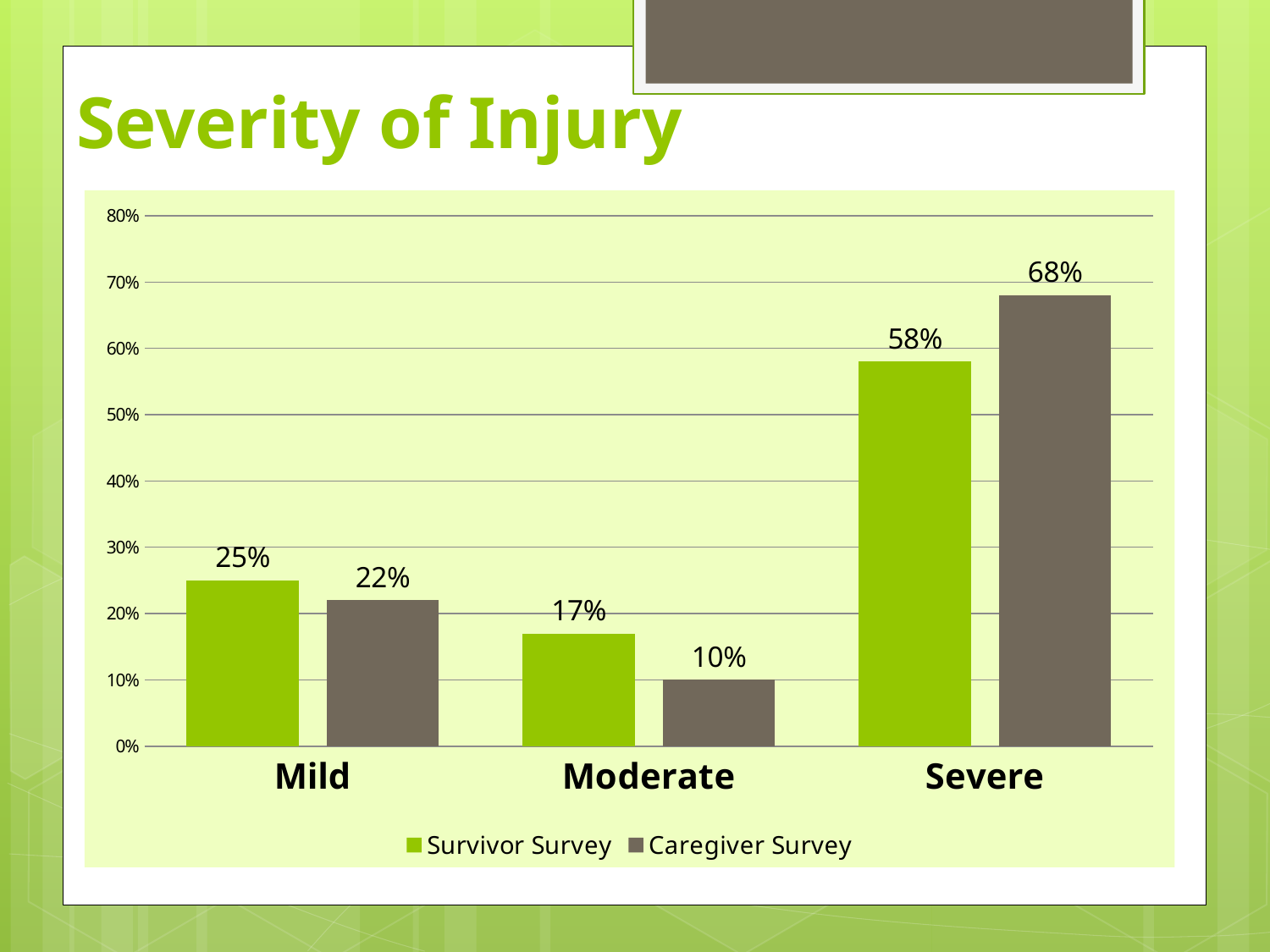
How many series does the legend list? 2 Which category has the highest Survivor Survey value? Severe What kind of chart is shown on the slide? bar chart How many categories are shown on the x axis? 3 What is the Caregiver Survey value for Moderate? 10% What is the difference between the Survivor Survey and Caregiver Survey values for Moderate? 7% Which category has the lowest Caregiver Survey value? Moderate Is the Survivor Survey value for Severe greater or less than 50%? greater What is the Caregiver Survey value for Severe? 68% Which is larger for Mild, the Survivor Survey value or the Caregiver Survey value? Survivor Survey What is the Survivor Survey value for Mild? 25% What is the difference between the Caregiver Survey and Survivor Survey values for Severe? 10%